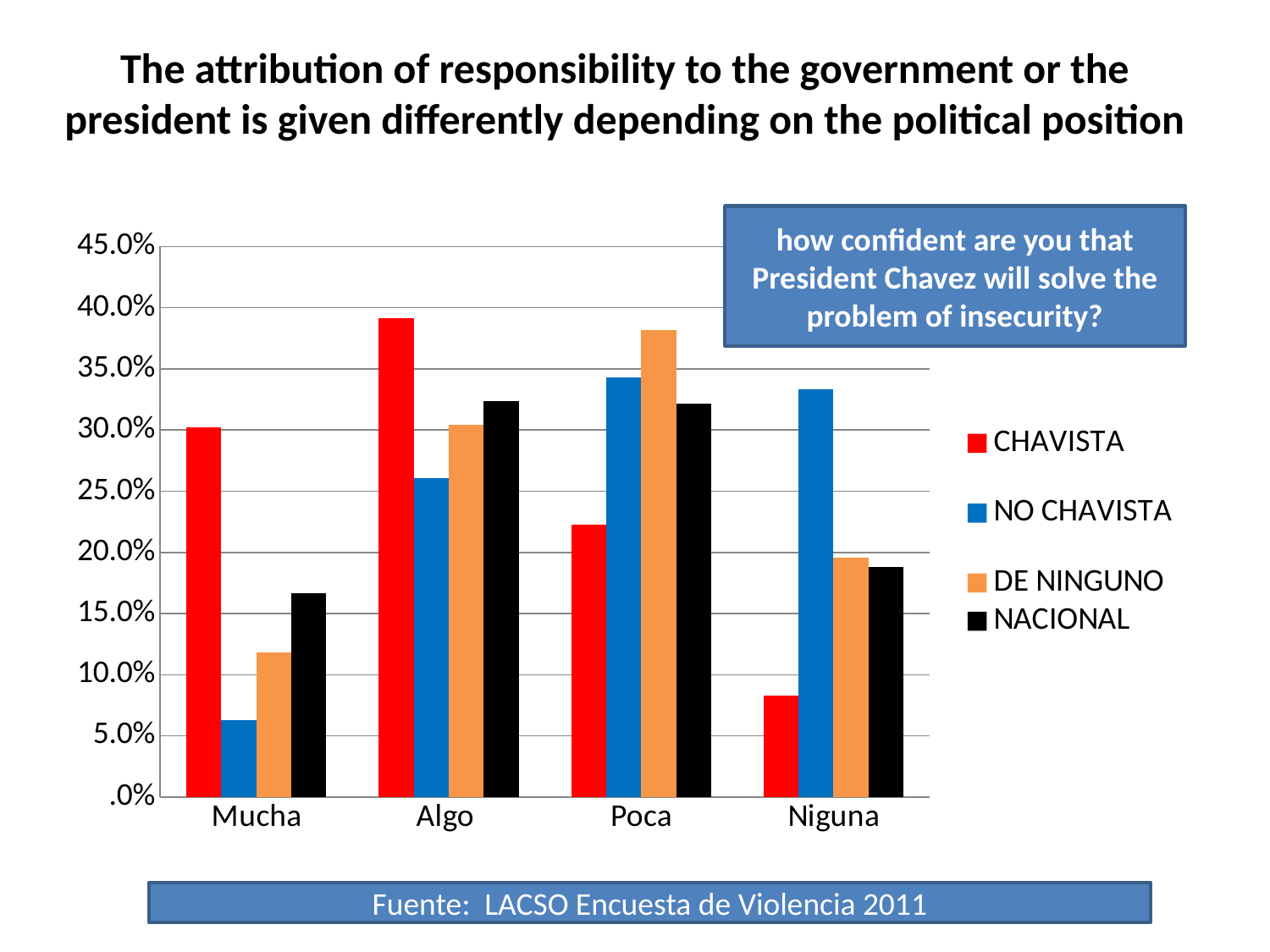
Is the CHAVISTA value for Mucha greater or less than 25.0%? greater In the Niguna category, which series has the highest bar? NO CHAVISTA How many categories are shown on the x axis? 4 For which category is the NO CHAVISTA bar the lowest? Mucha How many series does the legend list? 4 Is the DE NINGUNO value for Poca greater or less than 35.0%? greater For which category is the CHAVISTA bar the highest? Algo In the Mucha category, which is larger: CHAVISTA or NO CHAVISTA? CHAVISTA Is the NO CHAVISTA value for Mucha greater or less than 10.0%? less What colour represents the NACIONAL series in the legend? black What source is cited below the chart? Fuente: LACSO Encuesta de Violencia 2011 What kind of chart is shown on the slide? bar chart